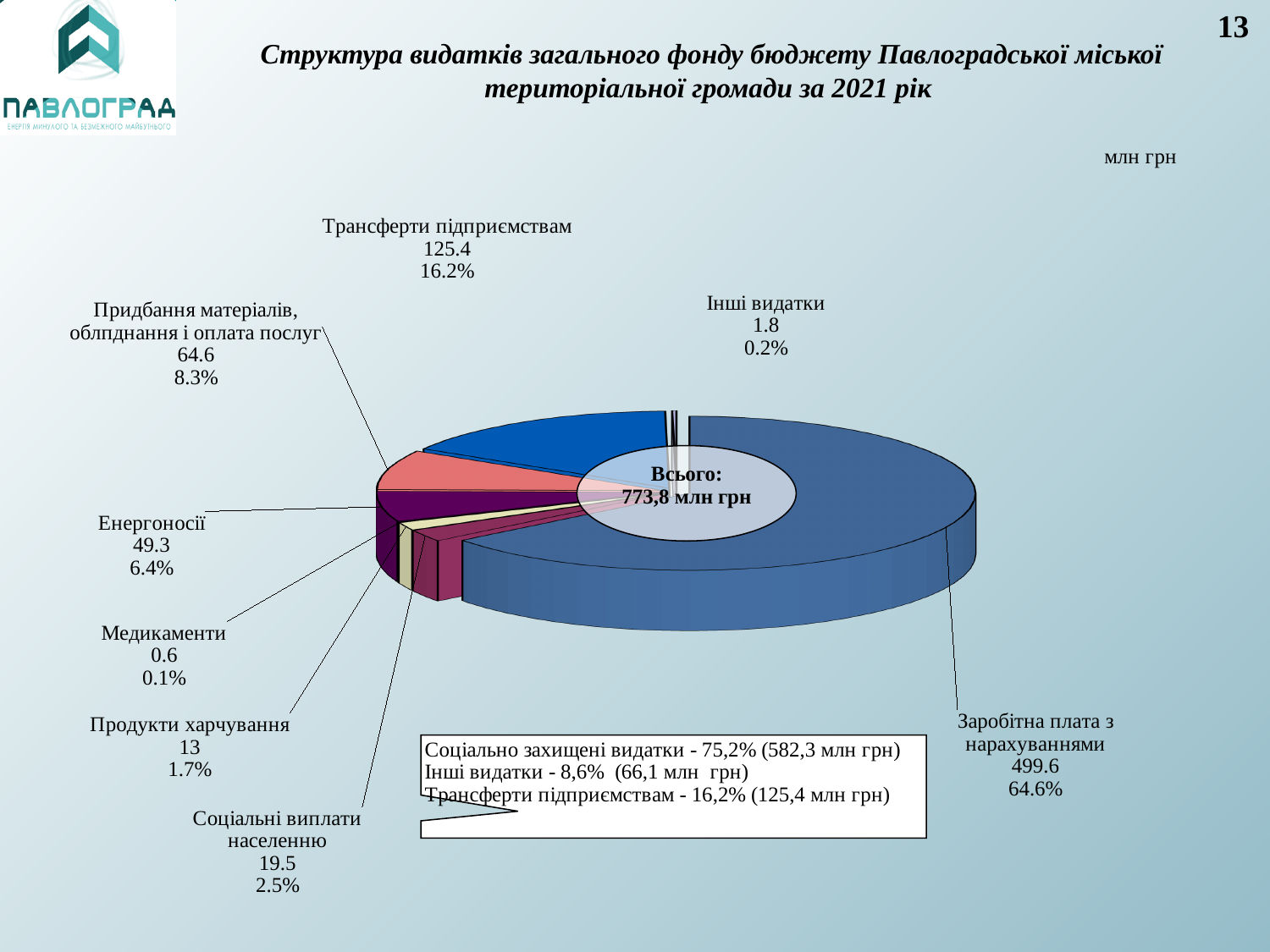
Which category has the largest slice of the pie? Заробітна плата з нарахуваннями What is the value for Заробітна плата з нарахуваннями? 499.6 How many categories are shown in the pie chart? 8 What kind of chart is shown on the slide? pie chart What is the value for Енергоносії? 49.3 What total is shown in the centre of the pie chart? 773,8 млн грн What share of the pie does Трансферти підприємствам represent? 16.2% What percentage is shown for Медикаменти? 0.1% What is the difference between the values for Трансферти підприємствам and Придбання матеріалів, облпднання і оплата послуг? 60.8 Which category has the smallest slice of the pie? Медикаменти Which is larger, the value for Соціальні виплати населенню or the value for Продукти харчування? Соціальні виплати населенню What is the value for Інші видатки? 1.8